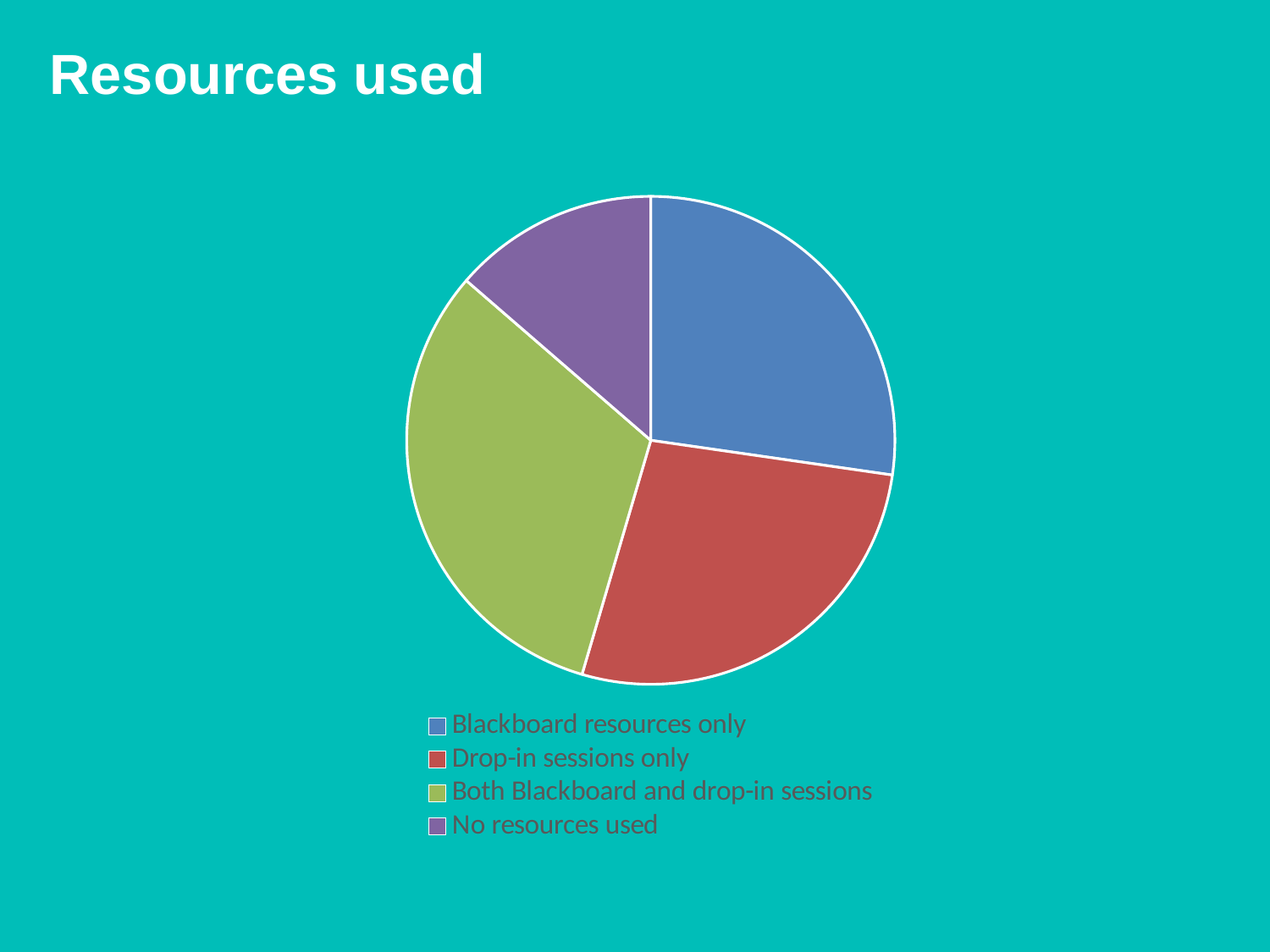
Which slice is larger: 'Both Blackboard and drop-in sessions' or 'No resources used'? Both Blackboard and drop-in sessions Which colour represents 'Drop-in sessions only' in the pie chart? red What kind of chart is shown on the slide? pie chart How many entries does the legend list? 4 Which slice is larger: 'Blackboard resources only' or 'No resources used'? Blackboard resources only Which category has the smallest slice of the pie? No resources used Which slice is larger: 'Drop-in sessions only' or 'No resources used'? Drop-in sessions only How many slices does the pie chart have? 4 What is the title of the slide containing the pie chart? Resources used